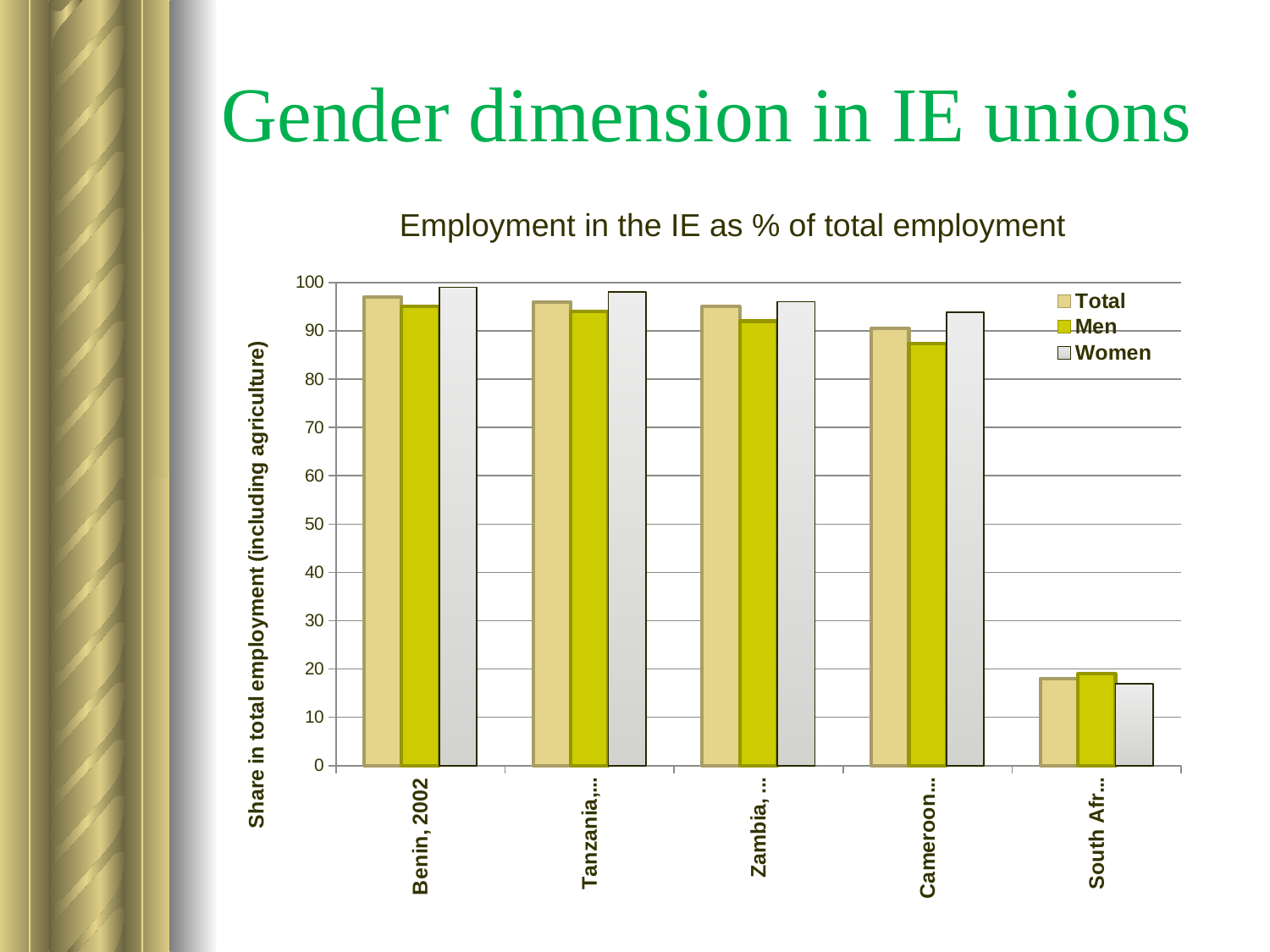
What kind of chart is shown on the slide? bar chart For Cameroon, which is larger: the Men value or the Women value? Women Which country has the highest Women share of employment in the IE? Benin, 2002 What is the title of the chart? Employment in the IE as % of total employment Is the Total value for Benin, 2002 greater or less than 90? greater Do the Total values rise or fall moving from left to right along the x axis? fall How many series does the legend list? 3 Which country has the lowest Total share of employment in the IE? South Africa For Zambia, which is larger: the Total value or the Men value? Total How many countries (categories) are shown on the x axis? 5 Is the Men value for South Africa greater or less than 30? less Is the Men value for Cameroon greater or less than 90? less